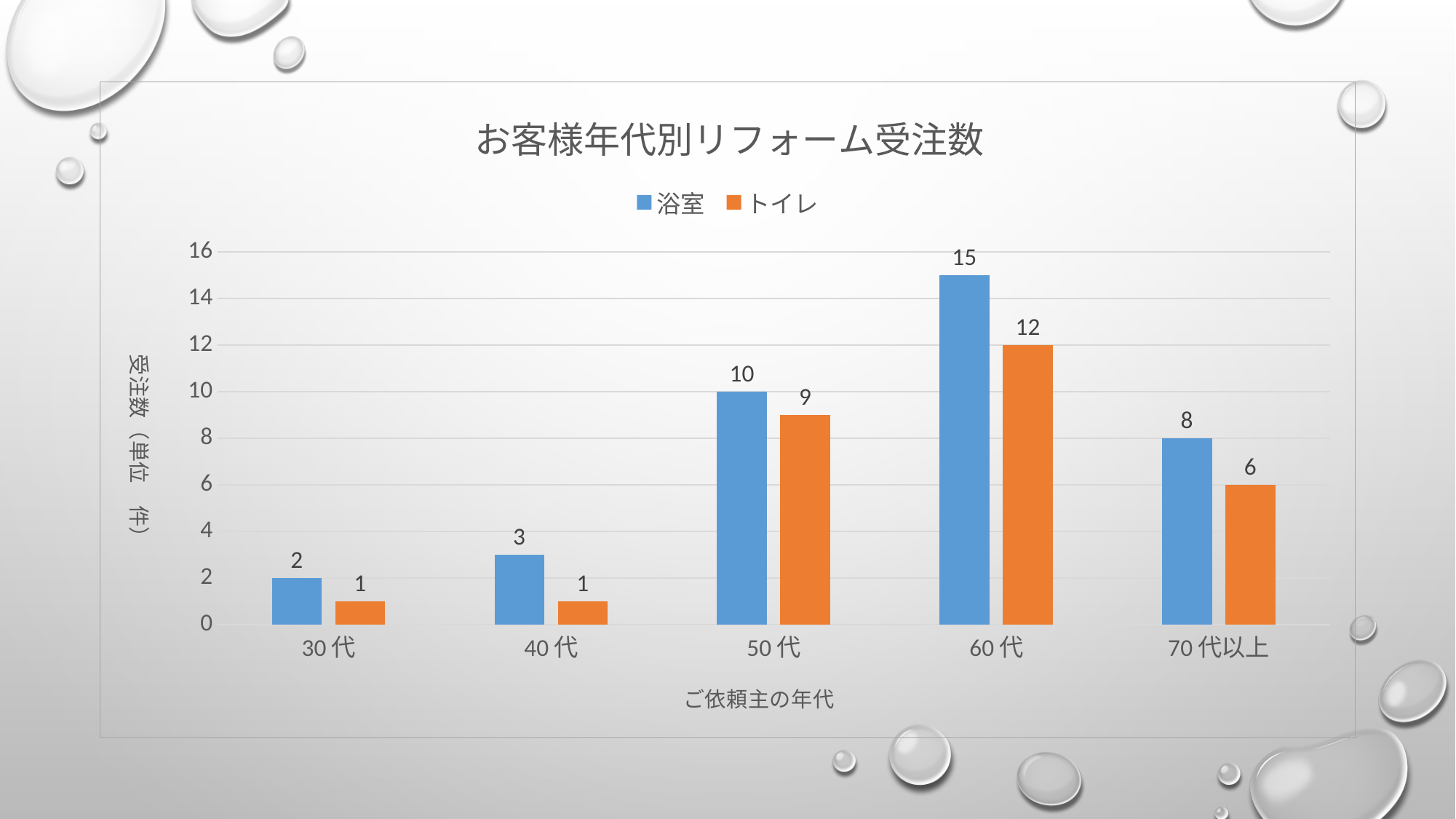
What is the value for 浴室 in the 60代 category? 15 What is the difference between the 浴室 values for 50代 and 40代? 7 How many age categories are shown on the x axis? 5 Which age category has the highest 浴室 value? 60代 Which is larger in the 70代以上 category, 浴室 or トイレ? 浴室 Which age category has the lowest 浴室 value? 30代 What is the difference between the 浴室 and トイレ values in the 60代 category? 3 What is the value for トイレ in the 50代 category? 9 What kind of chart is shown on the slide? Bar chart How many series does the legend list? 2 What is the value for トイレ in the 70代以上 category? 6 What is the title of the chart? お客様年代別リフォーム受注数